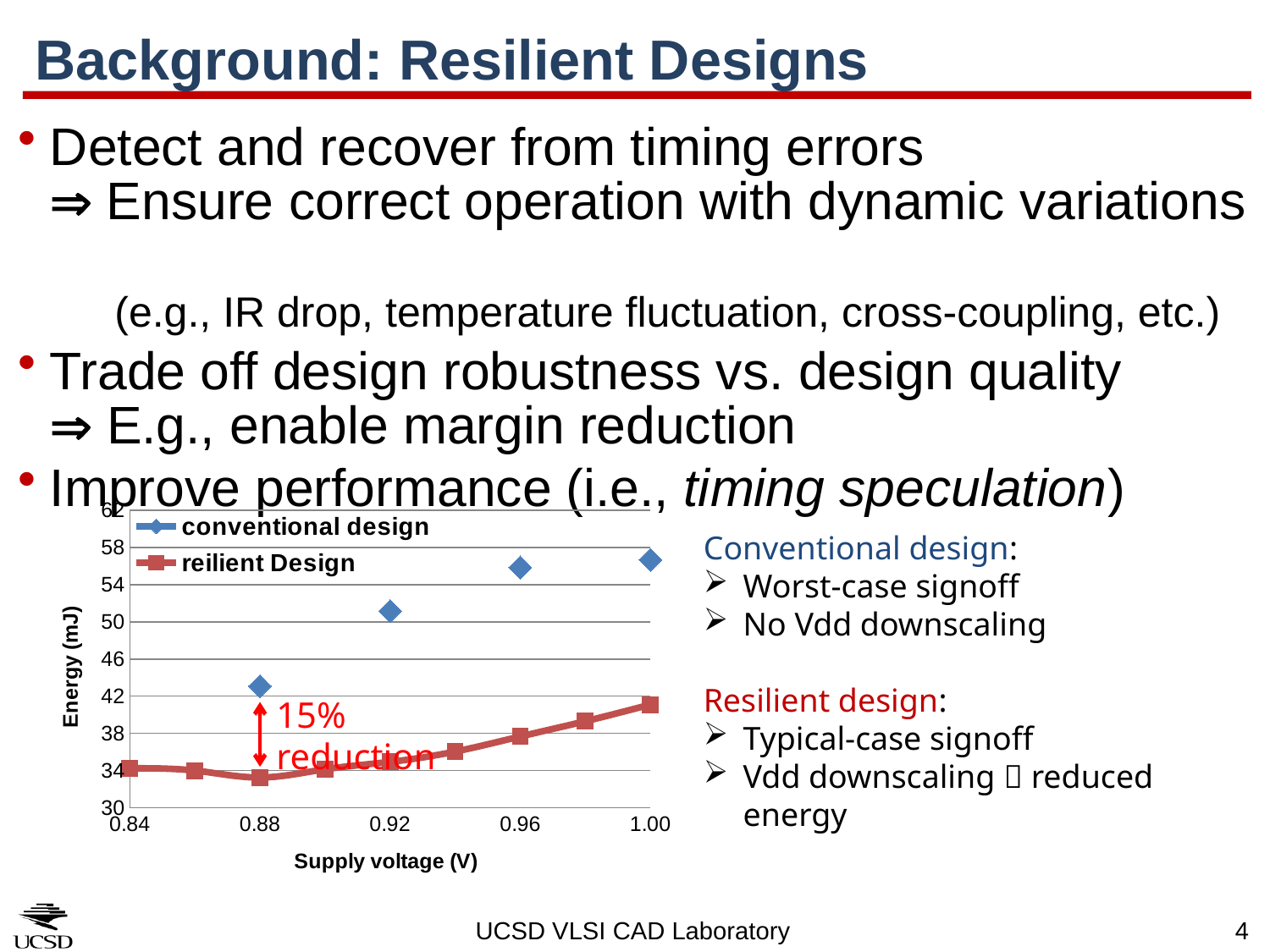
How many data points are plotted for the resilient design series? 9 What is the title of the chart's y axis? Energy (mJ) What kind of chart is shown on the slide? line chart How many data points are plotted for the conventional design series? 4 At 0.88 V, which series has the higher energy, conventional design or resilient design? conventional design Is the energy of the conventional design at 1.00 V greater or less than 54? greater What is the title of the chart's x axis? Supply voltage (V) Does the energy of the resilient design rise or fall as supply voltage increases from 0.92 V to 1.00 V? rise Is the energy of the resilient design at 0.88 V greater or less than 38? less How many series does the chart's legend list? 2 Is the energy of the conventional design at 0.92 V greater or less than 46? greater